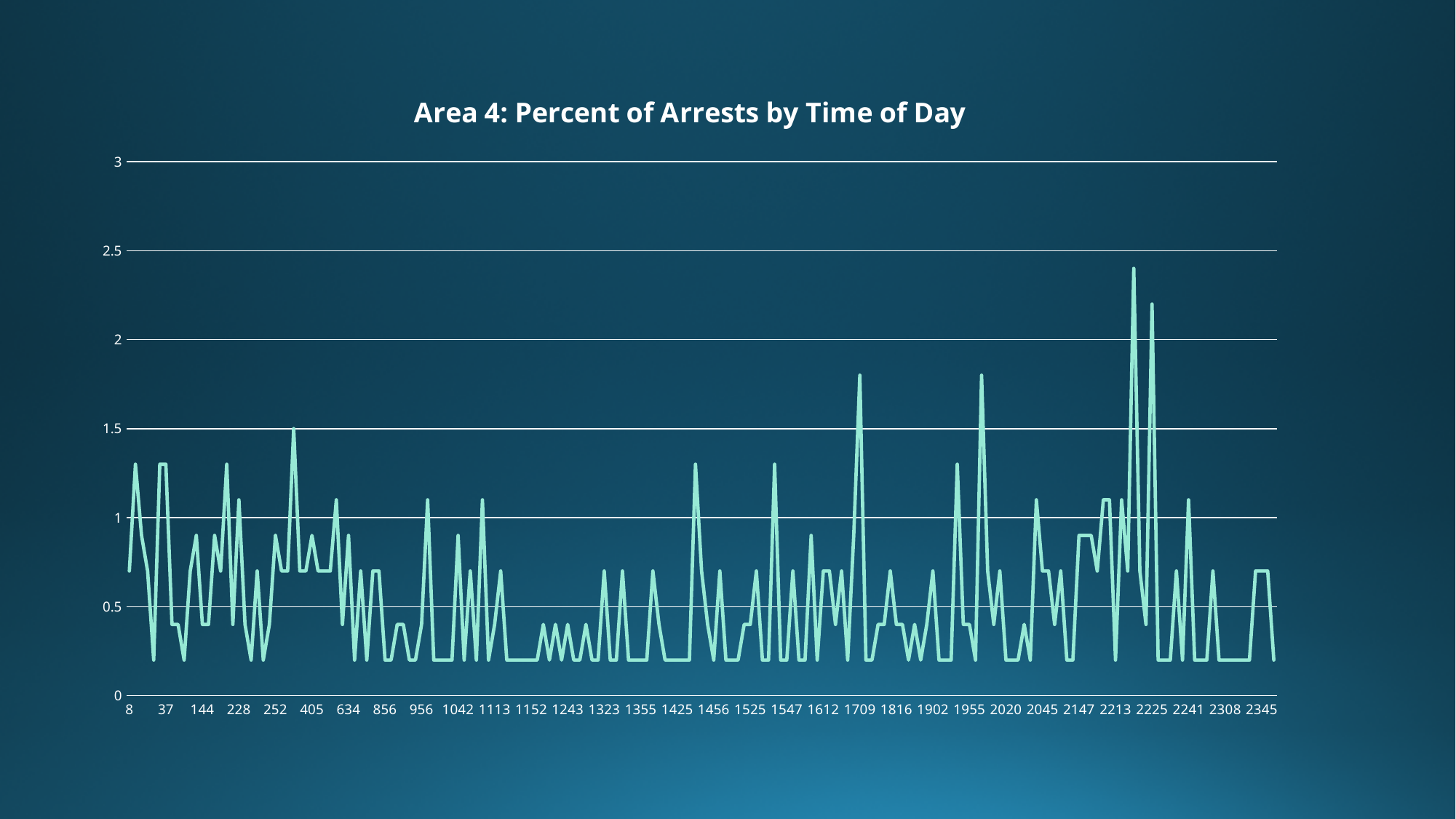
Is the value at time 8 greater or less than 1? less Is the value at time 405 greater or less than 1? less Is the value at time 1152 greater or less than 0.5? less How many time labels are printed along the horizontal axis? 32 What is the title of the chart? Area 4: Percent of Arrests by Time of Day What is the highest value shown on the vertical axis? 3 What kind of chart is shown on the slide? Line chart